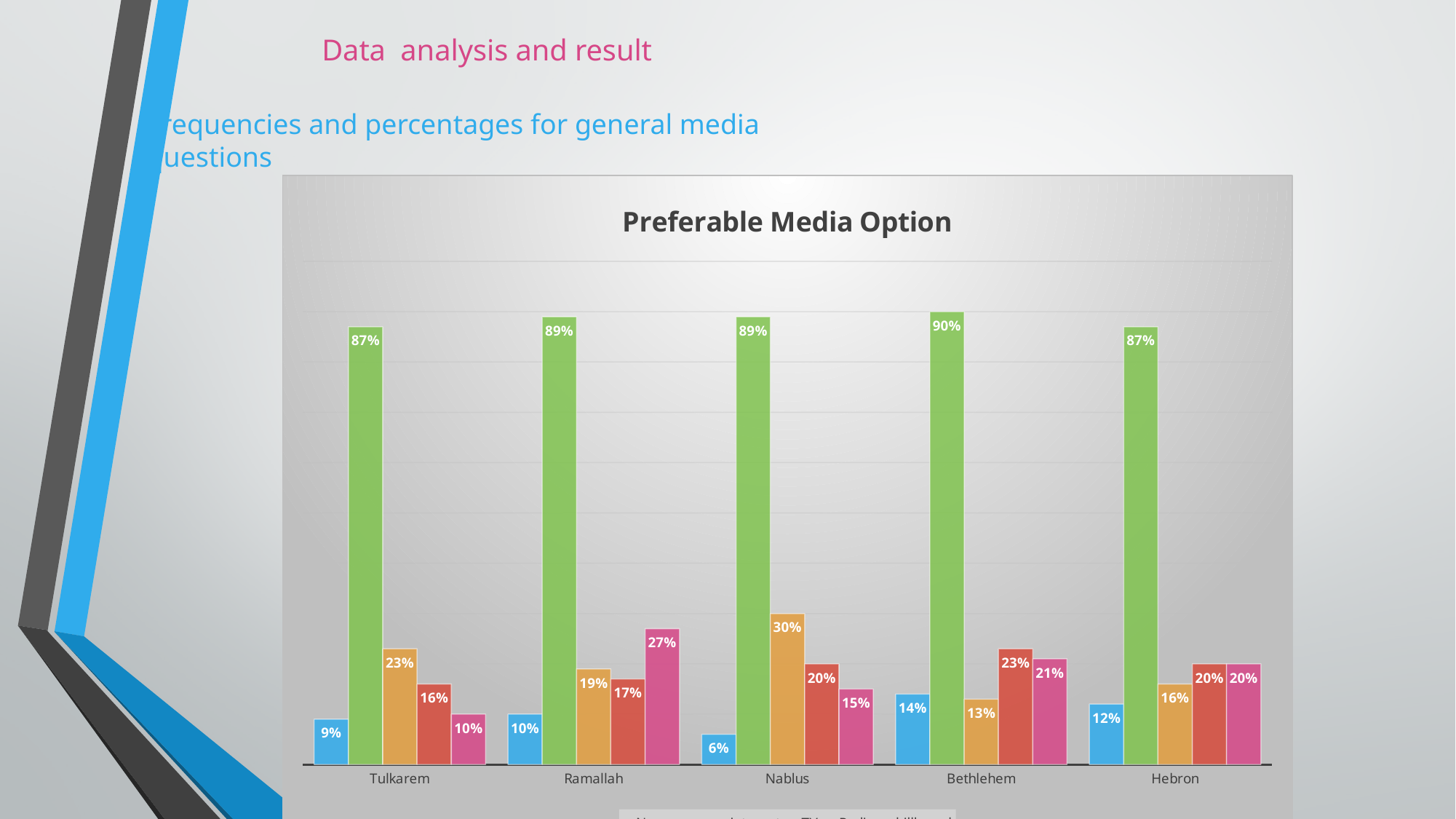
What is the value of the orange bar for Nablus? 30% What is the value of the green bar for Bethlehem in the Preferable Media Option chart? 90% How many cities are shown on the x axis of the chart? 5 What kind of chart is shown on the slide? Bar chart What is the value of the blue bar for Nablus? 6% What is the difference between the orange bar for Nablus and the orange bar for Bethlehem? 17% What is the value of the pink bar for Ramallah? 27% What is the title of the chart? Preferable Media Option Which is larger, the red bar for Bethlehem or the red bar for Tulkarem? Bethlehem Which city has the highest value for the green bar? Bethlehem How many bars are shown for each city? 5 Which city has the lowest value for the blue bar? Nablus